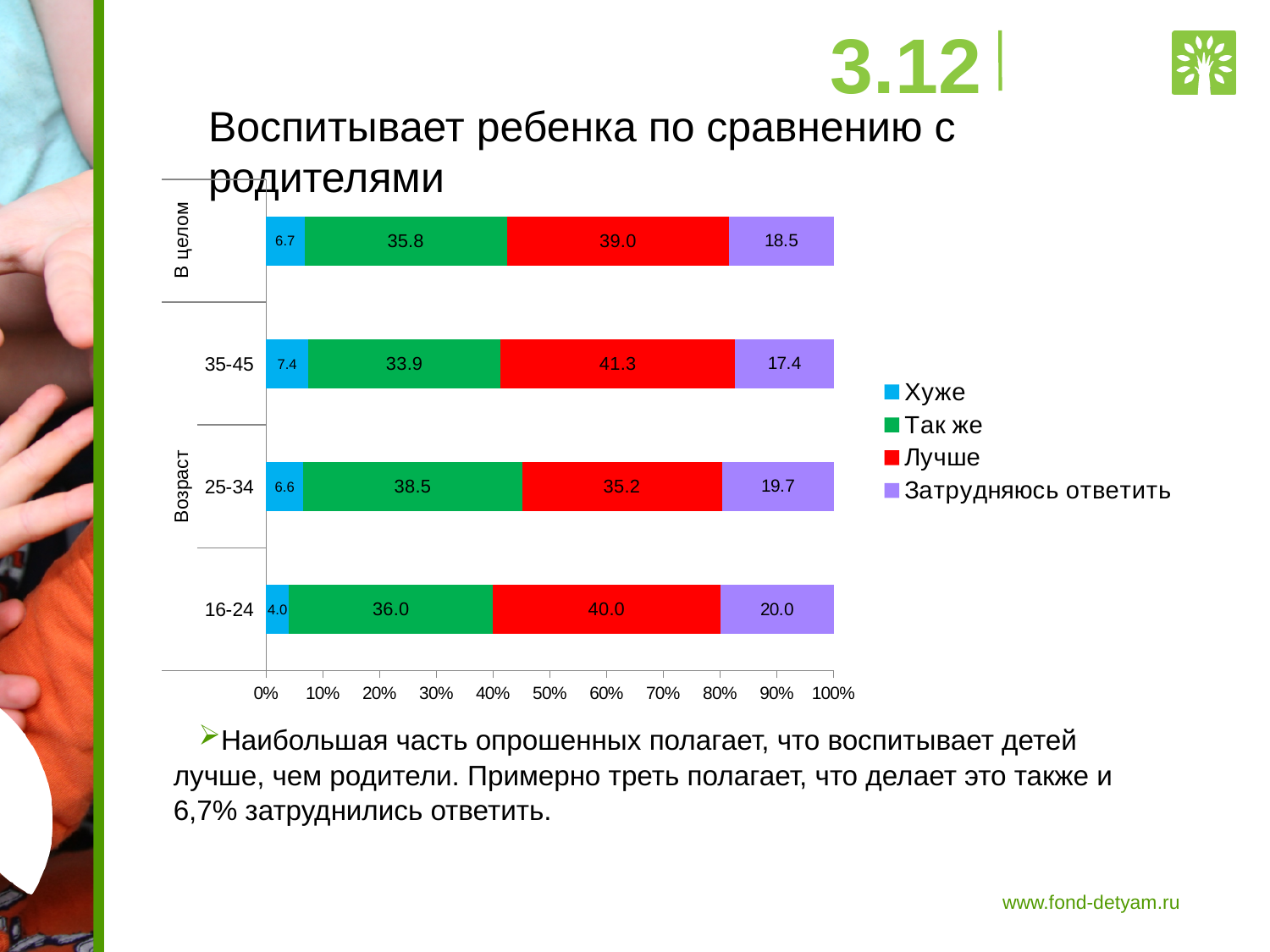
What kind of chart is shown on the slide? Stacked bar chart How many series does the legend list? 4 Which category has the lowest value for 'Хуже'? 16-24 What is the value of 'Хуже' for the 16-24 age group? 4.0 What is the value of 'Затрудняюсь ответить' for 'В целом'? 18.5 Which colour represents 'Лучше' in the chart? Red How many categories (bars) are shown on the chart? 4 Which is larger for the 25-34 group: 'Так же' or 'Лучше'? Так же What is the value of 'Так же' for the 25-34 age group? 38.5 What is the value of 'Лучше' for the 35-45 age group? 41.3 Which age group has the highest value for 'Лучше'? 35-45 What is the difference between the 'Лучше' values for 35-45 and 25-34? 6.1